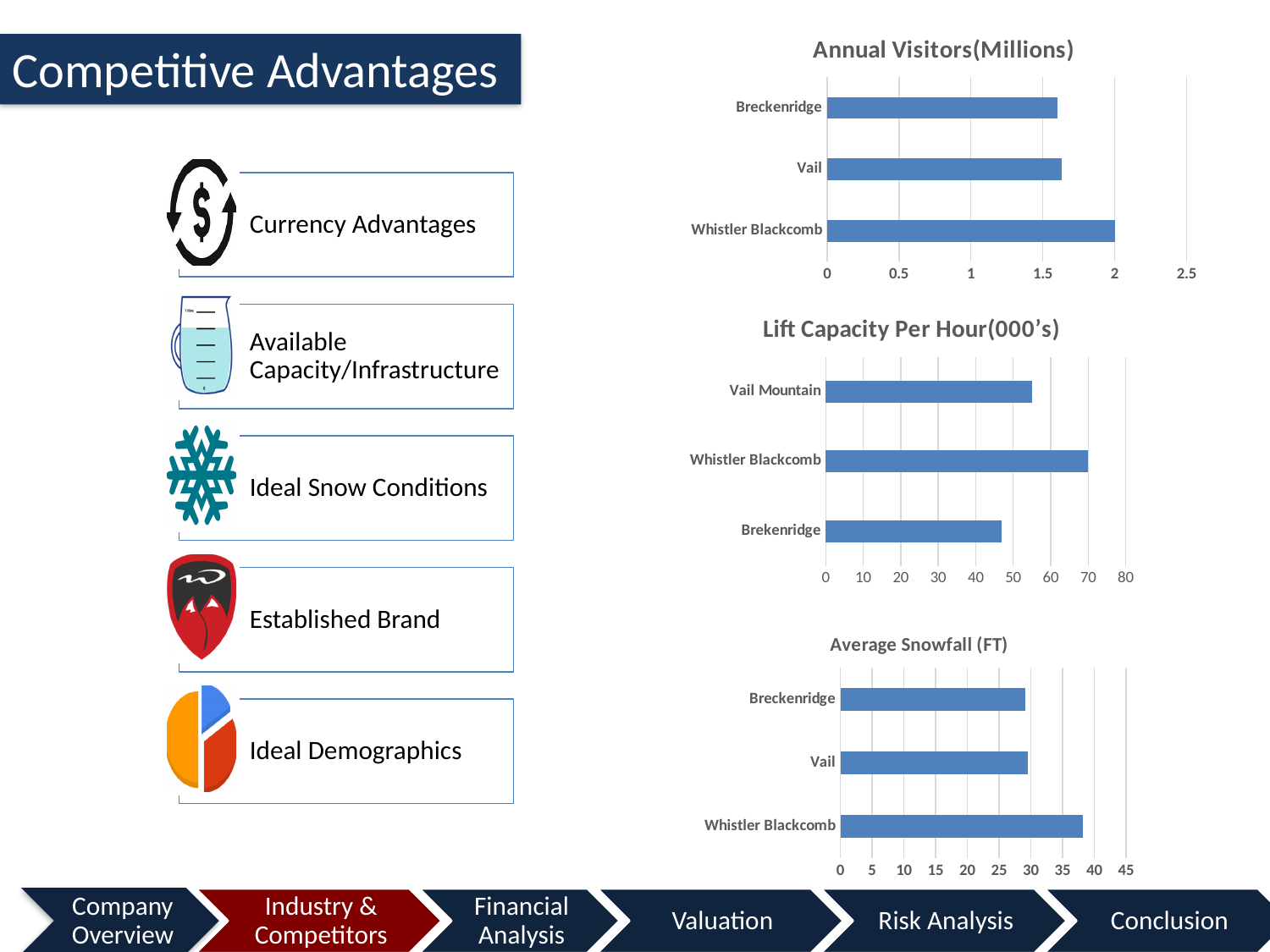
In the Lift Capacity Per Hour(000's) chart, is the value for Vail Mountain greater or less than 50? greater In the Lift Capacity Per Hour(000's) chart, which resort has the lowest lift capacity? Brekenridge In the Annual Visitors(Millions) chart, what is the value for Whistler Blackcomb? 2 In the Annual Visitors(Millions) chart, is the value for Breckenridge greater or less than 1.5? greater What kind of chart is the Lift Capacity Per Hour(000's) chart? bar chart In the Annual Visitors(Millions) chart, how many resorts are shown? 3 In the Lift Capacity Per Hour(000's) chart, which resort has the highest lift capacity? Whistler Blackcomb In the Annual Visitors(Millions) chart, which resort has the highest number of annual visitors? Whistler Blackcomb In the Average Snowfall (FT) chart, which resort has the highest average snowfall? Whistler Blackcomb How many charts are shown on the slide? 3 In the Lift Capacity Per Hour(000's) chart, is the value for Brekenridge greater or less than 50? less